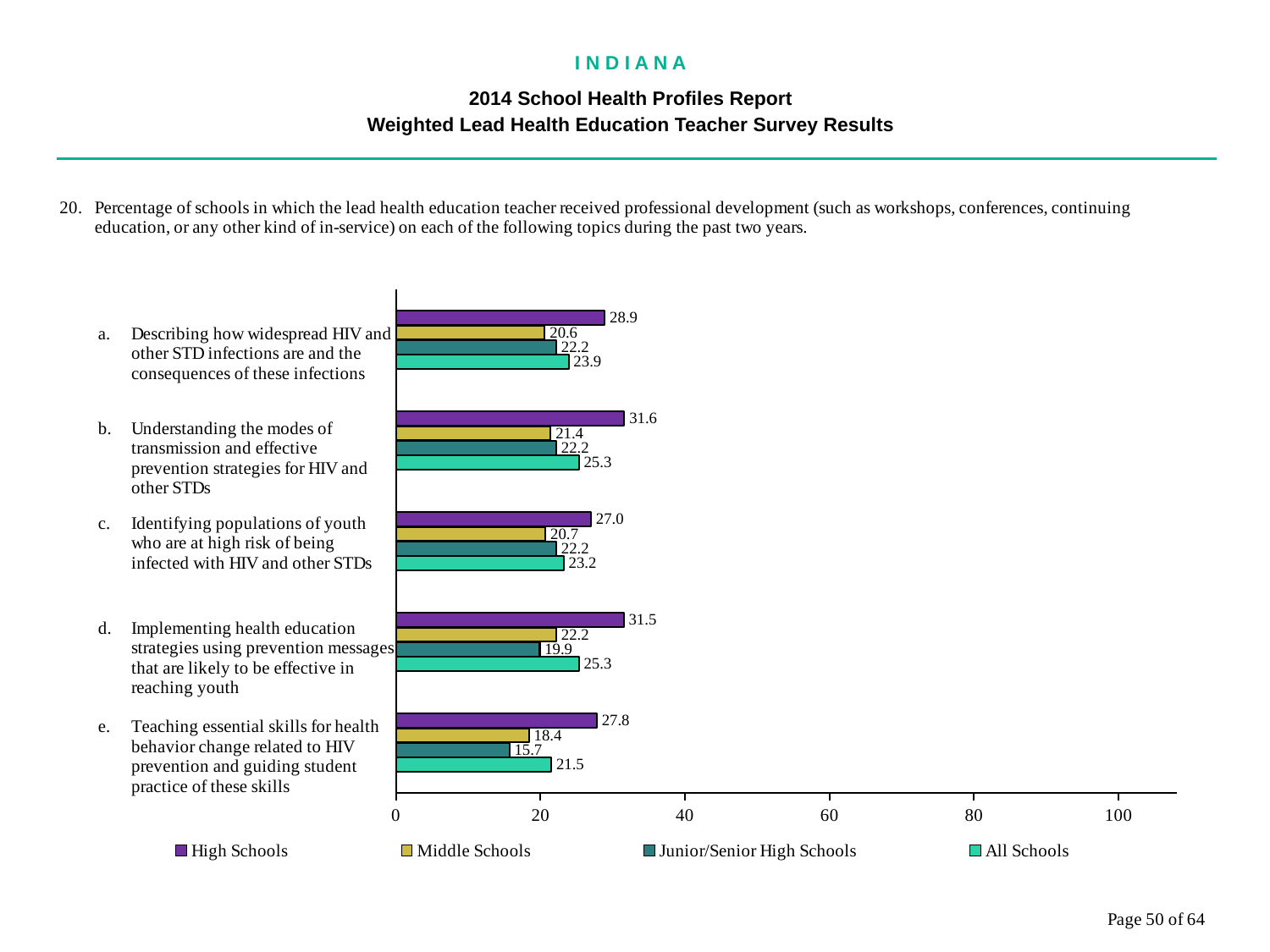
For topic d, which is larger: the Middle Schools value or the Junior/Senior High Schools value? Middle Schools Is the High Schools value for topic c greater or less than 20? greater How many topics are shown on the chart? 5 Which topic has the highest High Schools value? b. Understanding the modes of transmission and effective prevention strategies for HIV and other STDs How many series does the legend list? 4 What is the difference between the High Schools and Middle Schools values for topic e? 9.4 What is the Middle Schools value for topic a, describing how widespread HIV and other STD infections are? 20.6 What is the High Schools value for topic b, understanding the modes of transmission and effective prevention strategies for HIV and other STDs? 31.6 What is the All Schools value for topic e, teaching essential skills for health behavior change related to HIV prevention? 21.5 Which topic has the lowest Junior/Senior High Schools value? e. Teaching essential skills for health behavior change related to HIV prevention and guiding student practice of these skills What is the Junior/Senior High Schools value for topic d, implementing health education strategies using prevention messages? 19.9 What kind of chart is shown on the slide? Bar chart